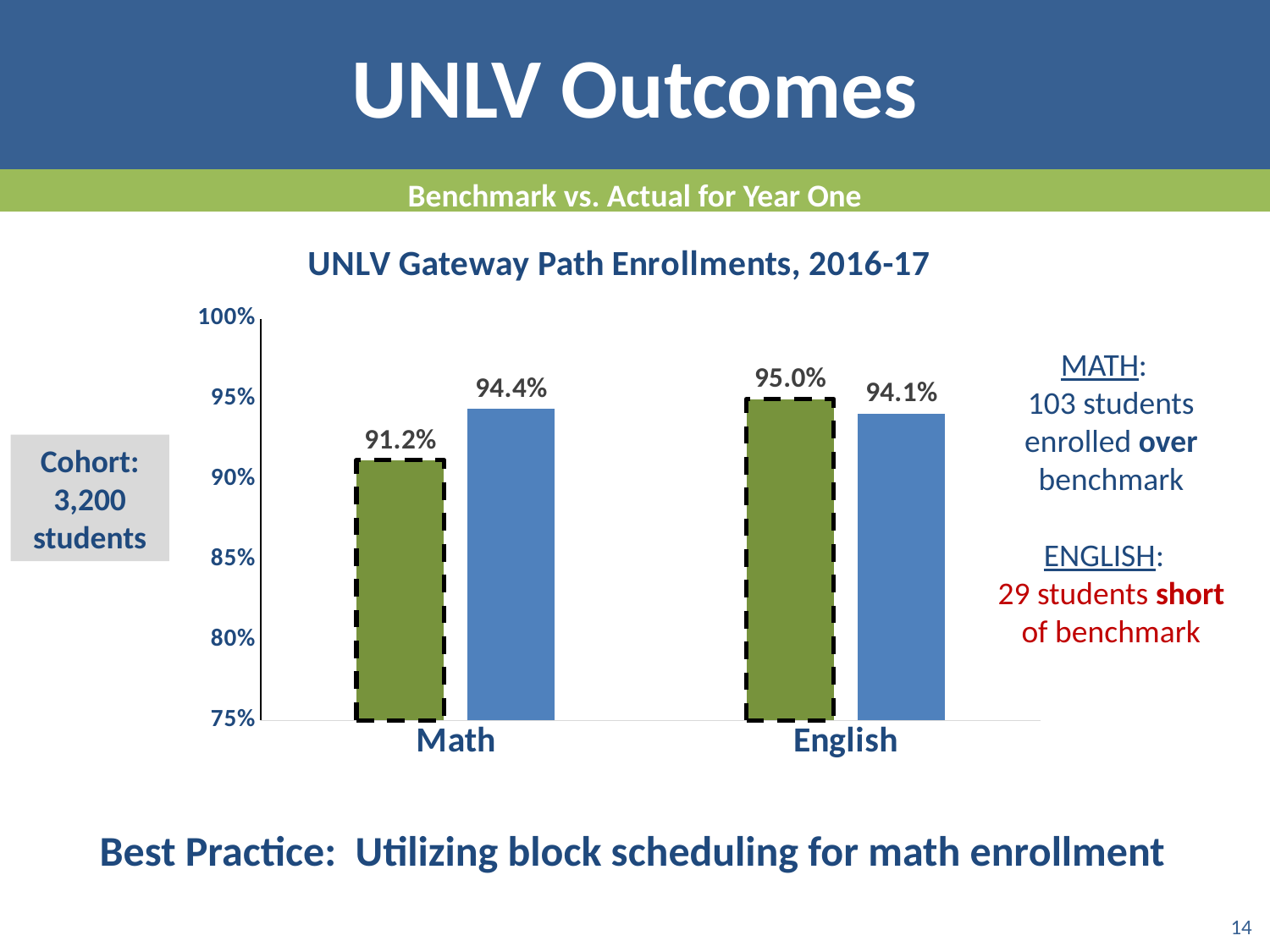
Is the value of the green dashed bar for Math greater or less than 90%? greater What is the difference between the blue bar and the green dashed bar for Math? 3.2% Which bar in the chart has the highest value? English green dashed bar (95.0%) How many categories are shown on the x axis of the chart? 2 What is the value of the blue bar for English? 94.1% What is the value of the green dashed bar for Math? 91.2% Which bar in the chart has the lowest value? Math green dashed bar (91.2%) What kind of chart is shown on the slide? bar chart What is the title of the chart? UNLV Gateway Path Enrollments, 2016-17 What is the value of the green dashed bar for English? 95.0% What is the value of the blue bar for Math? 94.4% For English, which is larger: the green dashed bar or the blue bar? the green dashed bar